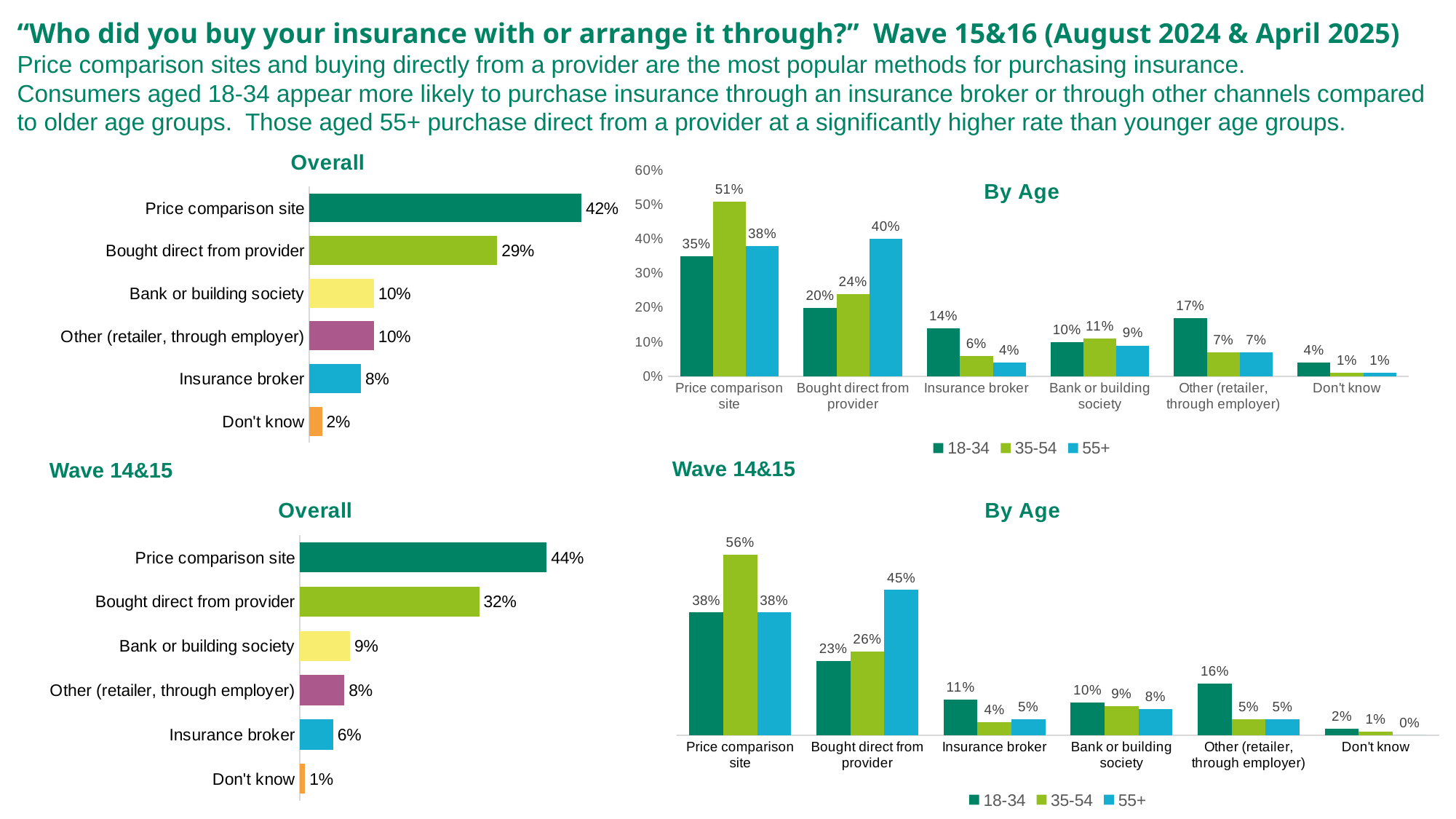
What type of chart is the top-left Overall chart (Wave 15&16)? Bar chart In the top-left Overall chart (Wave 15&16), what is the difference between 'Price comparison site' and 'Bought direct from provider'? 13% How many categories are shown in the bottom-left Overall chart (Wave 14&15)? 6 In the top-right By Age chart (Wave 15&16), what is the value for the 35-54 group for 'Price comparison site'? 51% In the top-right By Age chart (Wave 15&16), which age group has the highest value for 'Bought direct from provider'? 55+ In the top-left Overall chart (Wave 15&16), which category has the lowest value? Don't know In the bottom-right By Age chart (Wave 14&15), what is the difference between the 35-54 and 18-34 values for 'Price comparison site'? 18% In the top-left Overall chart (Wave 15&16), what percentage bought their insurance through a price comparison site? 42% In the bottom-left Overall chart (Wave 14&15), which is larger: 'Bank or building society' or 'Insurance broker'? Bank or building society In the bottom-right By Age chart (Wave 14&15), what is the value for the 18-34 group for 'Other (retailer, through employer)'? 16% How many series does the legend of the top-right By Age chart (Wave 15&16) list? 3 In the bottom-left Overall chart (Wave 14&15), what percentage bought direct from a provider? 32%